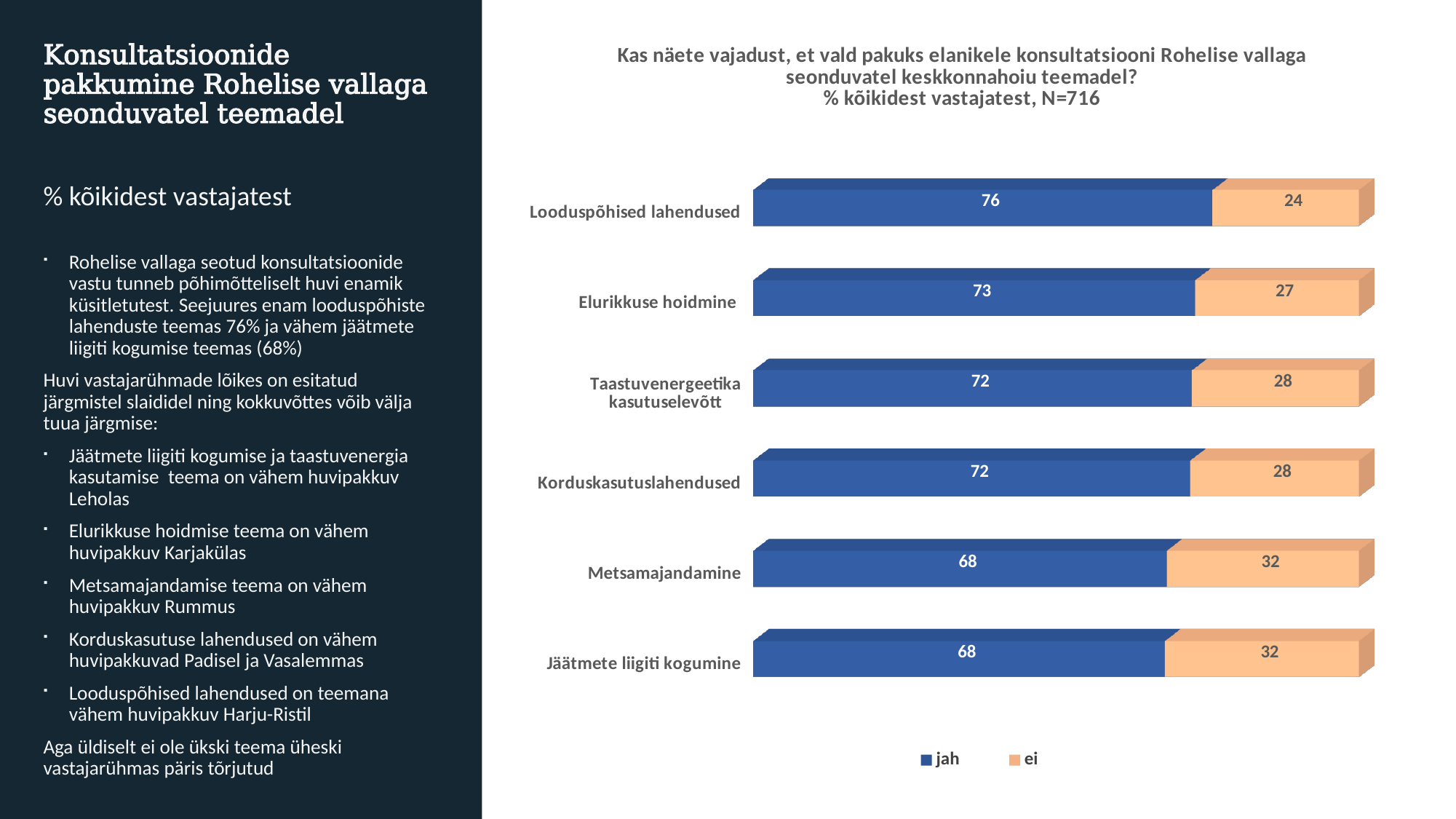
Which category has the highest 'jah' value? Looduspõhised lahendused What is the 'ei' value for Taastuvenergeetika kasutuselevõtt? 28 What is the total of the stacked bar for Korduskasutuslahendused? 100 Which is larger: the 'ei' value for Elurikkuse hoidmine or the 'ei' value for Metsamajandamine? Metsamajandamine What is the 'jah' value for Looduspõhised lahendused? 76 What kind of chart is shown on the slide? Stacked bar chart What is the difference between the 'jah' values for Looduspõhised lahendused and Jäätmete liigiti kogumine? 8 Which category has the lowest 'ei' value? Looduspõhised lahendused How many categories are shown in the chart? 6 What is the 'ei' value for Metsamajandamine? 32 What is the 'jah' value for Elurikkuse hoidmine? 73 How many series does the legend list? 2